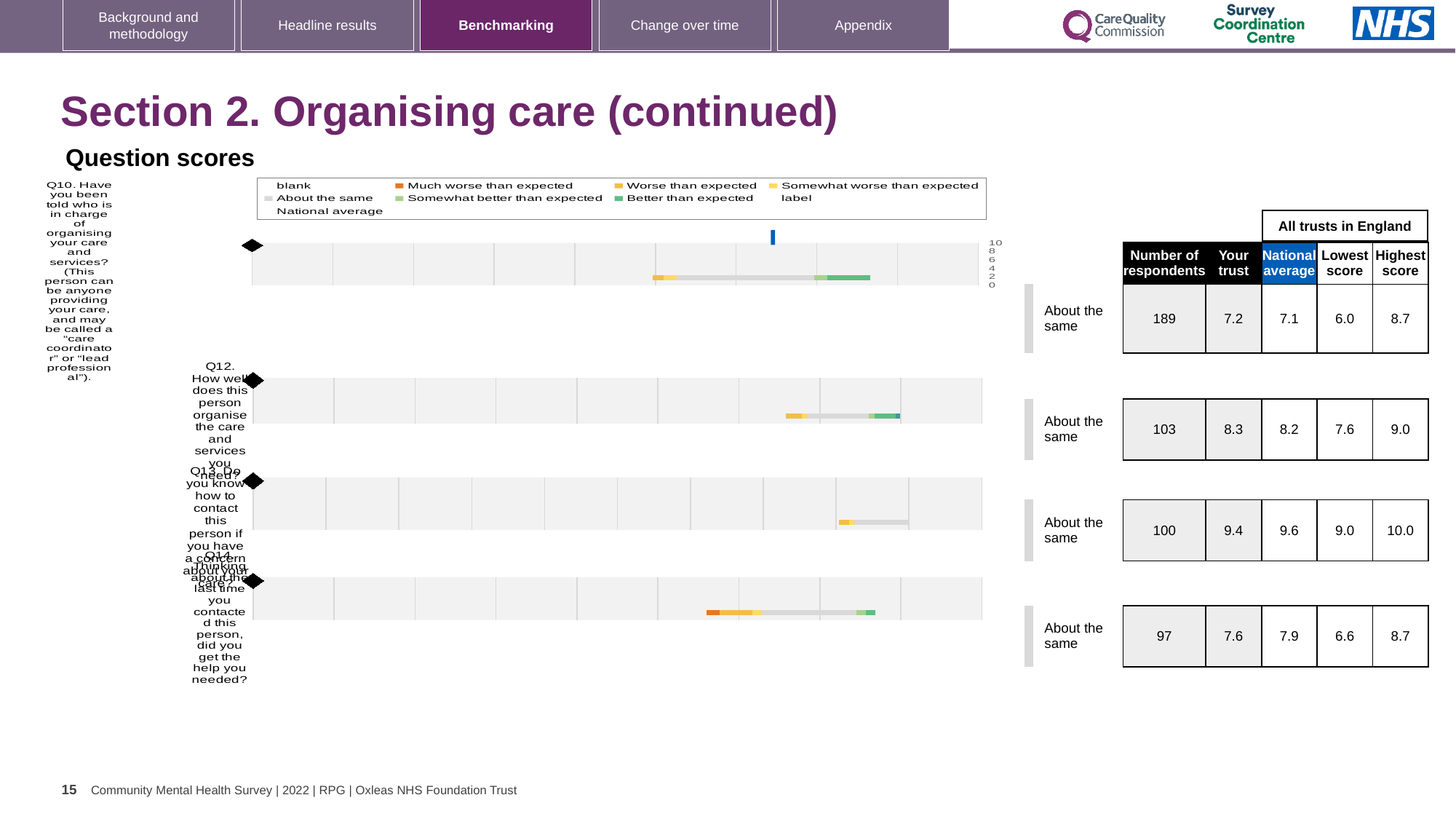
Which question has the lowest 'Your trust' score on this slide? Q10 For Q10, how much higher is the 'Your trust' score than the national average? 0.1 For Q13, what is the difference between the highest score and the lowest score among all trusts in England? 1.0 What benchmark category is shown for Q12? About the same How many respondents answered Q13 (Do you know how to contact this person if you have a concern about your care?)? 100 What kind of chart is used to show the question scores? Bar chart Which question has the highest 'Your trust' score on this slide? Q13 For Q14, which is larger: the 'Your trust' score or the national average? National average What is the national average score for Q12 (How well does this person organise the care and services you need?)? 8.2 What is the 'Your trust' score for Q10 (Have you been told who is in charge of organising your care and services?)? 7.2 How many questions are charted on this slide? 4 What is the highest score among all trusts in England for Q14 (did you get the help you needed?)? 8.7